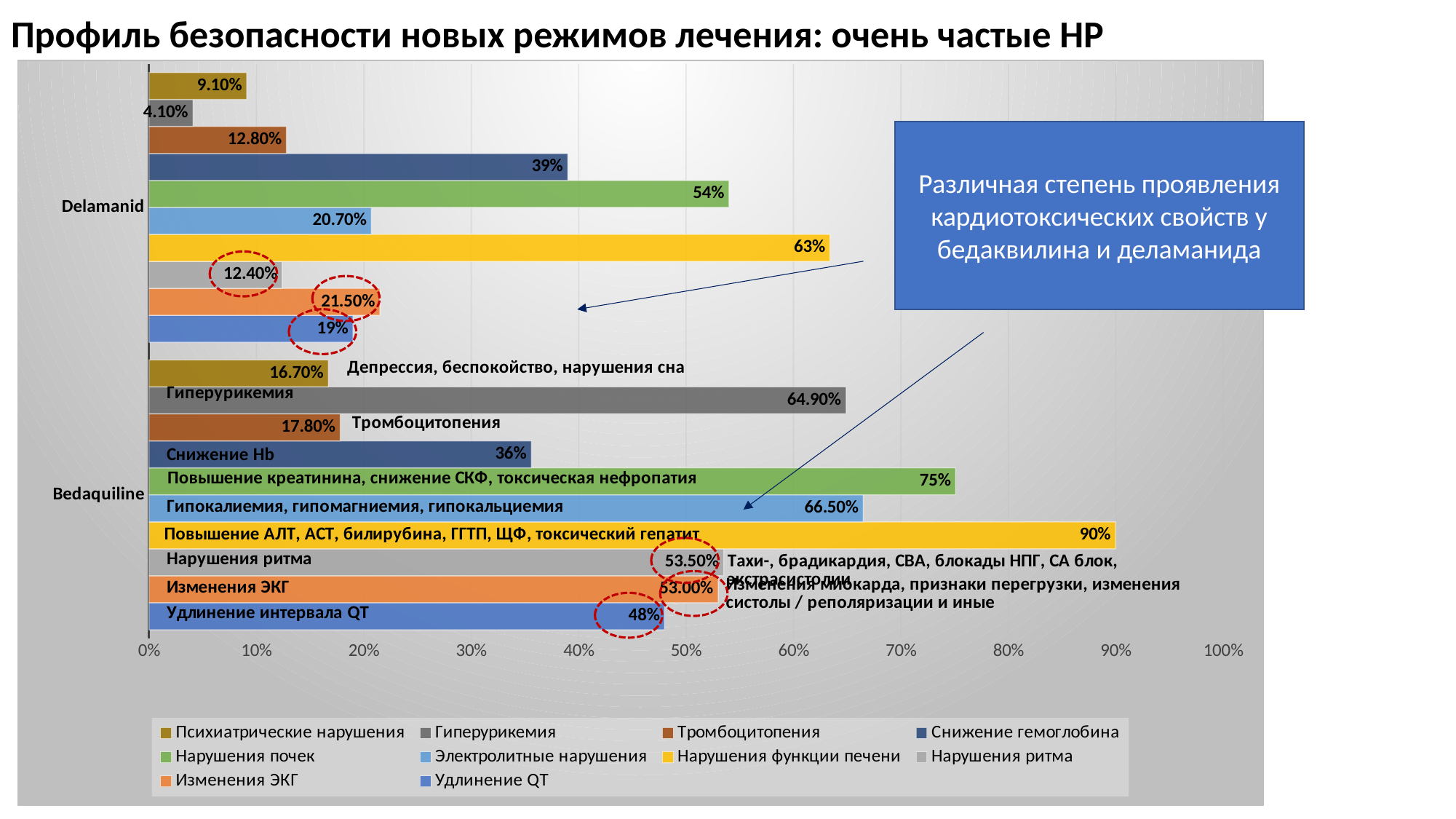
What colour are the bars for Нарушения функции печени? yellow What is the value for Удлинение QT for Bedaquiline? 48% What kind of chart is shown on the slide? bar chart Is the value for Нарушения почек for Bedaquiline greater or less than 70%? greater What is the value for Нарушения функции печени for Bedaquiline? 90% Which is larger: Снижение гемоглобина for Delamanid or for Bedaquiline? Delamanid What is the value for Гиперурикемия for Delamanid? 4.10% What is the value for Изменения ЭКГ for Delamanid? 21.50% How many series does the legend list? 10 Which series has the highest value for Delamanid? Нарушения функции печени What is the difference between the Нарушения функции печени values for Bedaquiline and Delamanid? 27% Which series has the lowest value for Bedaquiline? Психиатрические нарушения